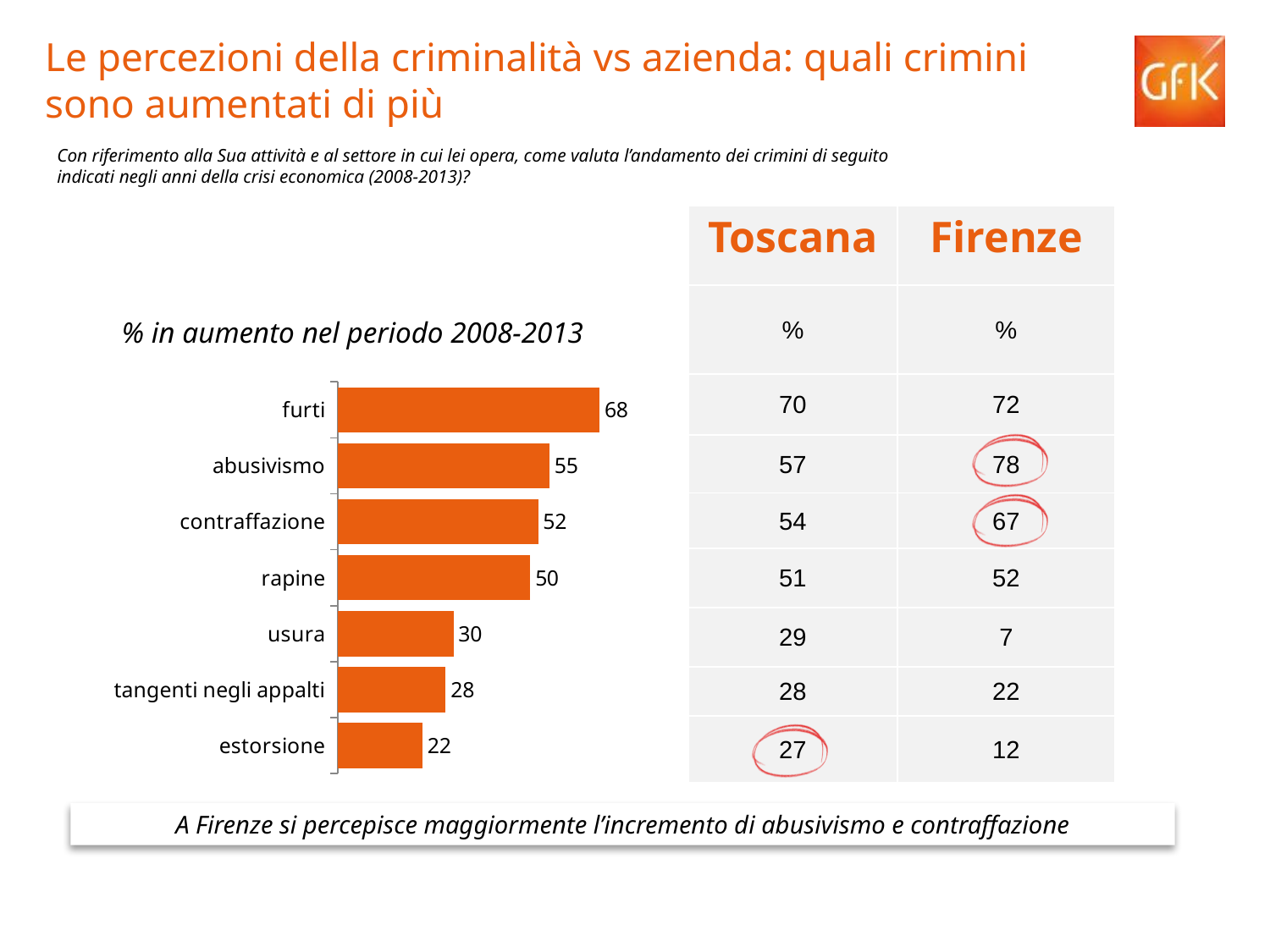
What is the value for furti in the bar chart? 68 What is the difference between the values for furti and estorsione in the bar chart? 46 What kind of chart is shown on the slide? bar chart How many categories are shown in the bar chart? 7 Which is larger in the bar chart, the value for contraffazione or the value for usura? contraffazione What is the value for usura in the bar chart? 30 What colour are the bars in the bar chart? orange Which category has the highest value in the bar chart? furti What is the difference between the values for abusivismo and rapine in the bar chart? 5 Which category has the lowest value in the bar chart? estorsione What is the title of the bar chart? % in aumento nel periodo 2008-2013 What is the value for tangenti negli appalti in the bar chart? 28